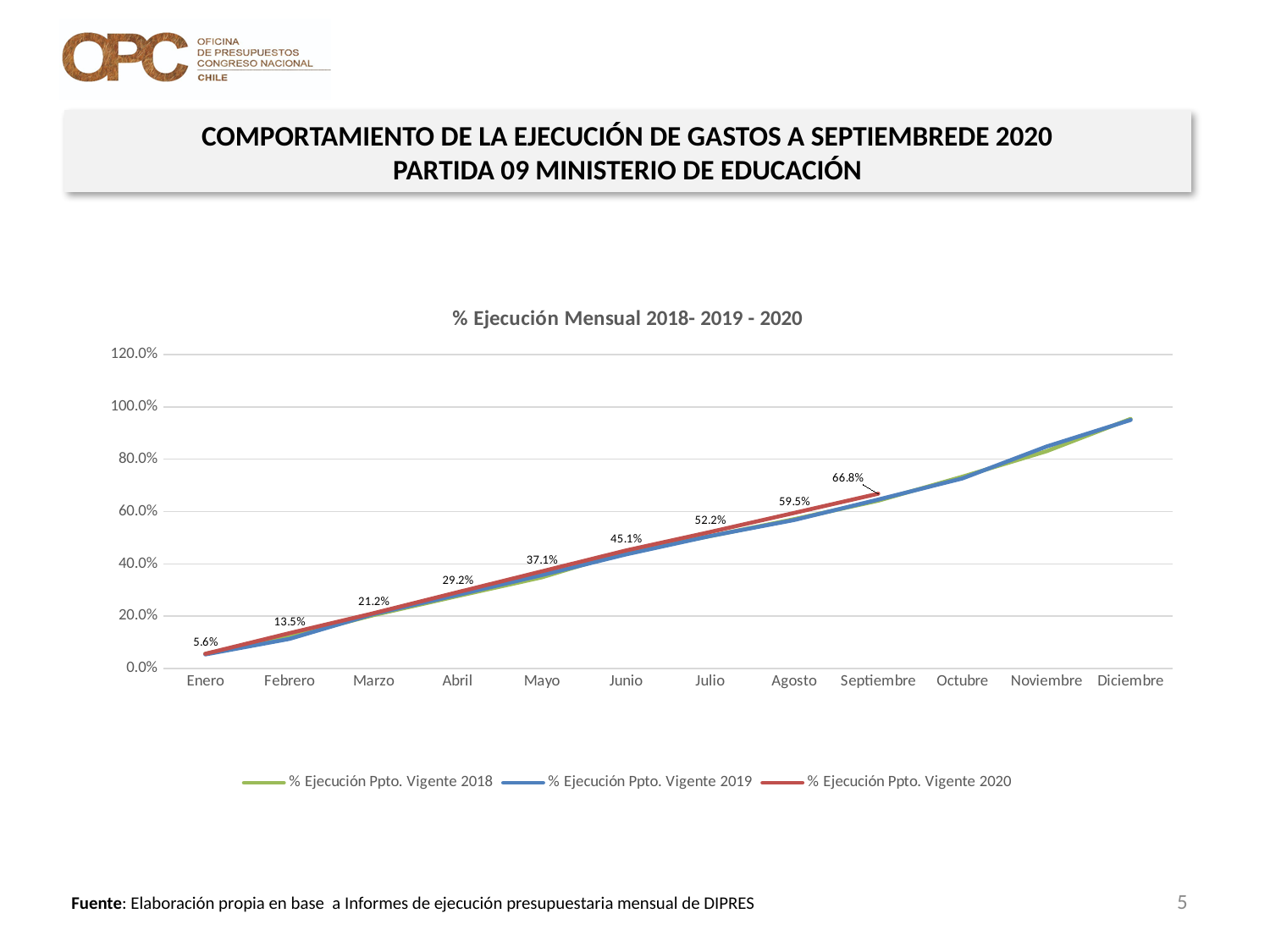
What is the difference between the 2020 values for Abril and Enero? 23.6% What is the value for % Ejecución Ppto. Vigente 2020 in Septiembre? 66.8% What is the difference between the 2020 values for Septiembre and Agosto? 7.3% Do the values for % Ejecución Ppto. Vigente 2020 rise or fall from Enero to Septiembre? rise How many months are shown on the x axis? 12 What is the value for % Ejecución Ppto. Vigente 2020 in Mayo? 37.1% What is the value for % Ejecución Ppto. Vigente 2020 in Enero? 5.6% Which month has the highest value for % Ejecución Ppto. Vigente 2020? Septiembre Is the value for % Ejecución Ppto. Vigente 2019 in Diciembre greater or less than 80.0%? greater What is the title of the chart? % Ejecución Mensual 2018- 2019 - 2020 What kind of chart is shown on the slide? line chart How many series does the legend list? 3